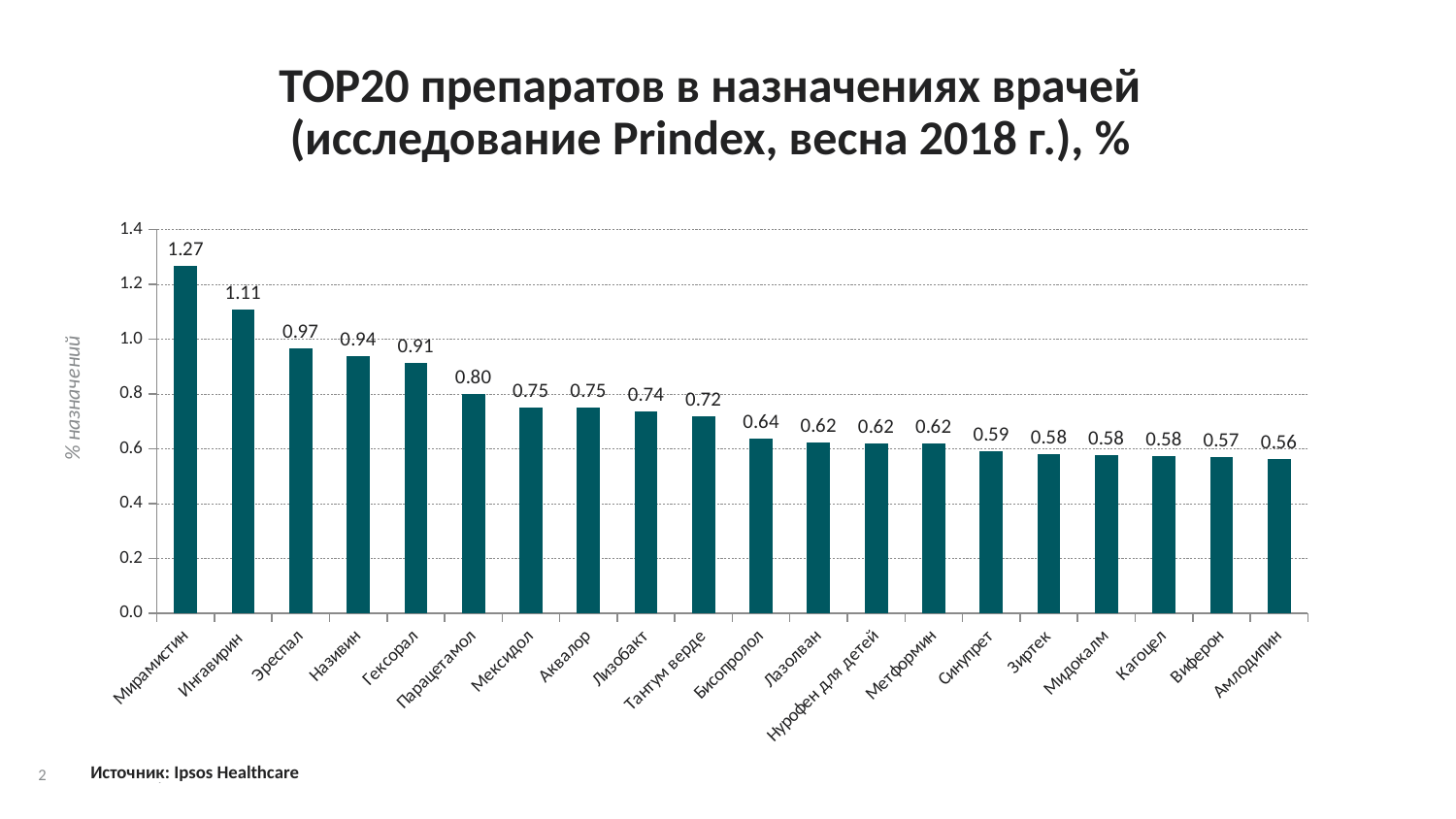
Do the values rise or fall from left to right along the x axis? fall Which is larger, the value for Эреспал or the value for Гексорал? Эреспал What is the value for Парацетамол? 0.80 Which drug has the lowest share of prescriptions? Амлодипин What kind of chart is shown on the slide? bar chart What is the value for Тантум верде? 0.72 What is the value for Мирамистин? 1.27 Which drug has the highest share of prescriptions? Мирамистин What is the value for Нурофен для детей? 0.62 Is the value for Бисопролол greater or less than 0.8? less How many drugs are shown on the chart? 20 What is the difference between the values for Мирамистин and Ингавирин? 0.16